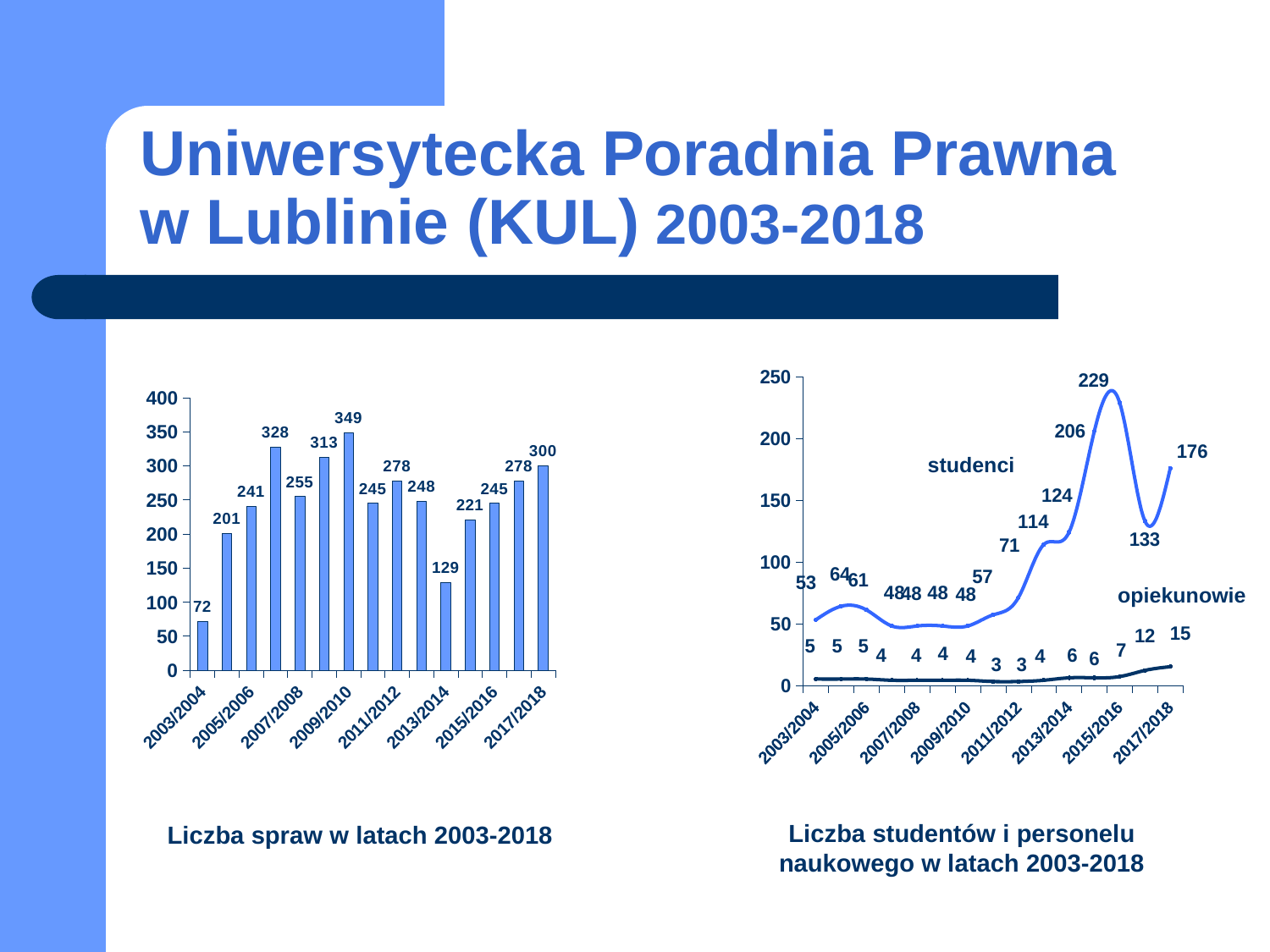
In the right chart 'Liczba studentów i personelu naukowego w latach 2003-2018', what is the value of 'studenci' for 2017/2018? 176 In the left chart 'Liczba spraw w latach 2003-2018', what is the difference between the values for 2017/2018 and 2003/2004? 228 In the left chart 'Liczba spraw w latach 2003-2018', which year has the lowest value? 2003/2004 In the right chart 'Liczba studentów i personelu naukowego w latach 2003-2018', what is the value of 'opiekunowie' for 2017/2018? 15 How many bars are plotted in the left chart 'Liczba spraw w latach 2003-2018'? 15 In the right chart 'Liczba studentów i personelu naukowego w latach 2003-2018', what is the highest value of the 'studenci' series? 229 In the left chart 'Liczba spraw w latach 2003-2018', which year has the highest value? 2009/2010 In the left chart 'Liczba spraw w latach 2003-2018', what is the value for 2003/2004? 72 In the left chart 'Liczba spraw w latach 2003-2018', what is the value for 2017/2018? 300 In the left chart 'Liczba spraw w latach 2003-2018', is the value for 2013/2014 greater or less than 150? less What type of chart is the left chart, 'Liczba spraw w latach 2003-2018'? bar chart How many series are shown in the right chart 'Liczba studentów i personelu naukowego w latach 2003-2018'? 2